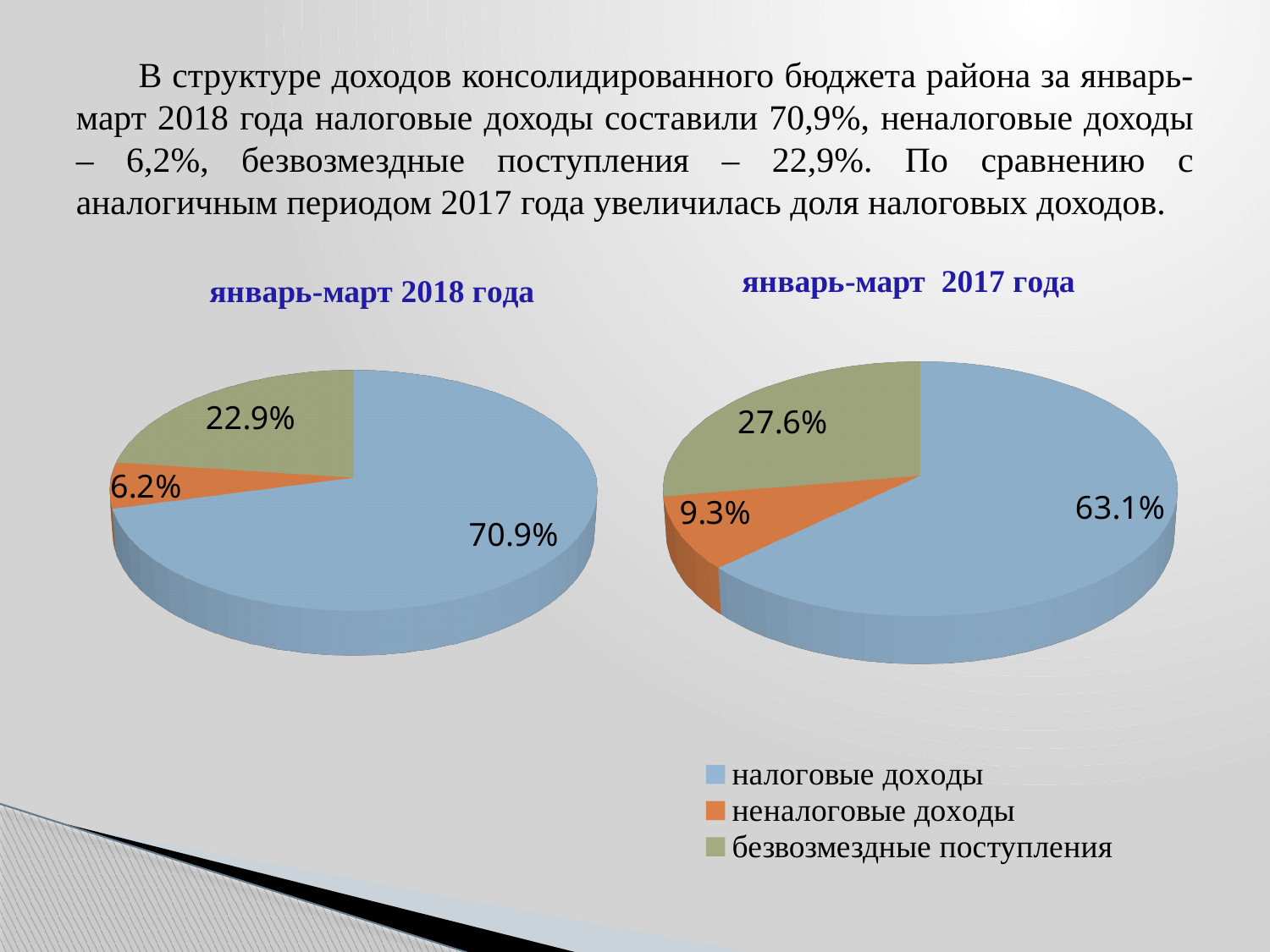
In the chart titled "январь-март 2017 года", what is the value for "неналоговые доходы"? 9.3% In the chart titled "январь-март 2018 года", what is the difference between the shares of "безвозмездные поступления" and "неналоговые доходы"? 16.7% How many slices does the chart titled "январь-март 2017 года" have? 3 What is the title of the left chart? январь-март 2018 года In the chart titled "январь-март 2017 года", what share does "безвозмездные поступления" have? 27.6% In the chart titled "январь-март 2018 года", what share does "налоговые доходы" have? 70.9% Which is larger: the share of "налоговые доходы" in the 2018 chart or in the 2017 chart? 2018 chart What type of chart is the one titled "январь-март 2018 года"? pie chart In the chart titled "январь-март 2018 года", which category has the smallest slice? неналоговые доходы What colour represents "безвозмездные поступления" in the legend? green In the chart titled "январь-март 2017 года", which category has the largest slice? налоговые доходы How many entries does the legend list? 3